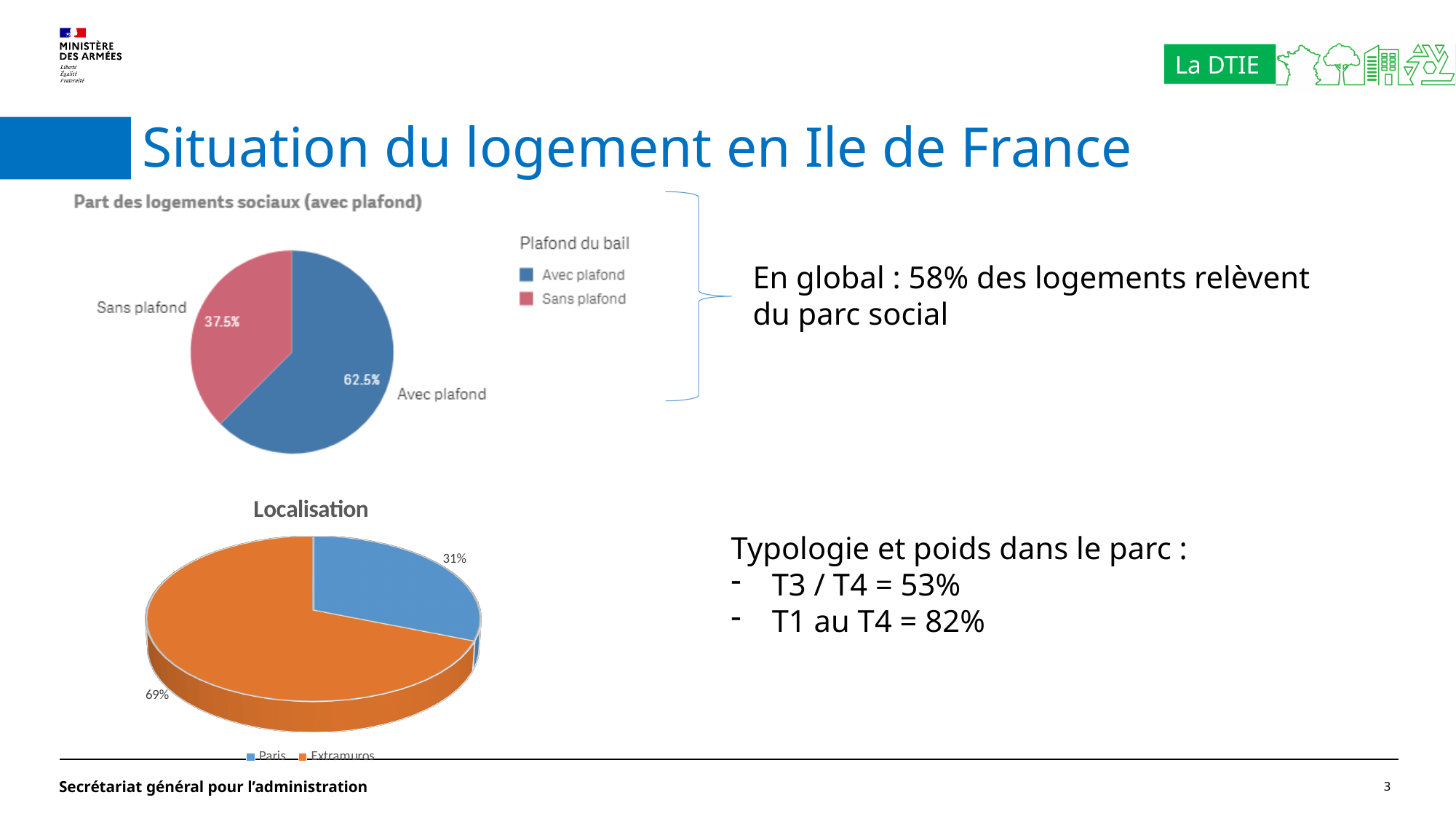
How many entries does the legend of the 'Part des logements sociaux (avec plafond)' chart list? 2 In the 'Localisation' chart, which slice is the smallest? Paris In the 'Localisation' chart, what share is labelled for 'Extramuros'? 69% In the 'Localisation' chart, what is the difference between the 'Extramuros' and 'Paris' shares? 38% In the 'Localisation' chart, which is larger: 'Paris' or 'Extramuros'? Extramuros In the 'Localisation' chart, what share is labelled for 'Paris'? 31% In the 'Part des logements sociaux (avec plafond)' chart, which slice is the largest? Avec plafond In the 'Part des logements sociaux (avec plafond)' chart, what share is labelled for 'Avec plafond'? 62.5% In the 'Part des logements sociaux (avec plafond)' chart, what share is labelled for 'Sans plafond'? 37.5% What type of chart is the 'Part des logements sociaux (avec plafond)' chart? Pie chart In the 'Localisation' chart, what colour is the 'Extramuros' slice? Orange In the 'Part des logements sociaux (avec plafond)' chart, what is the difference between the 'Avec plafond' and 'Sans plafond' shares? 25%